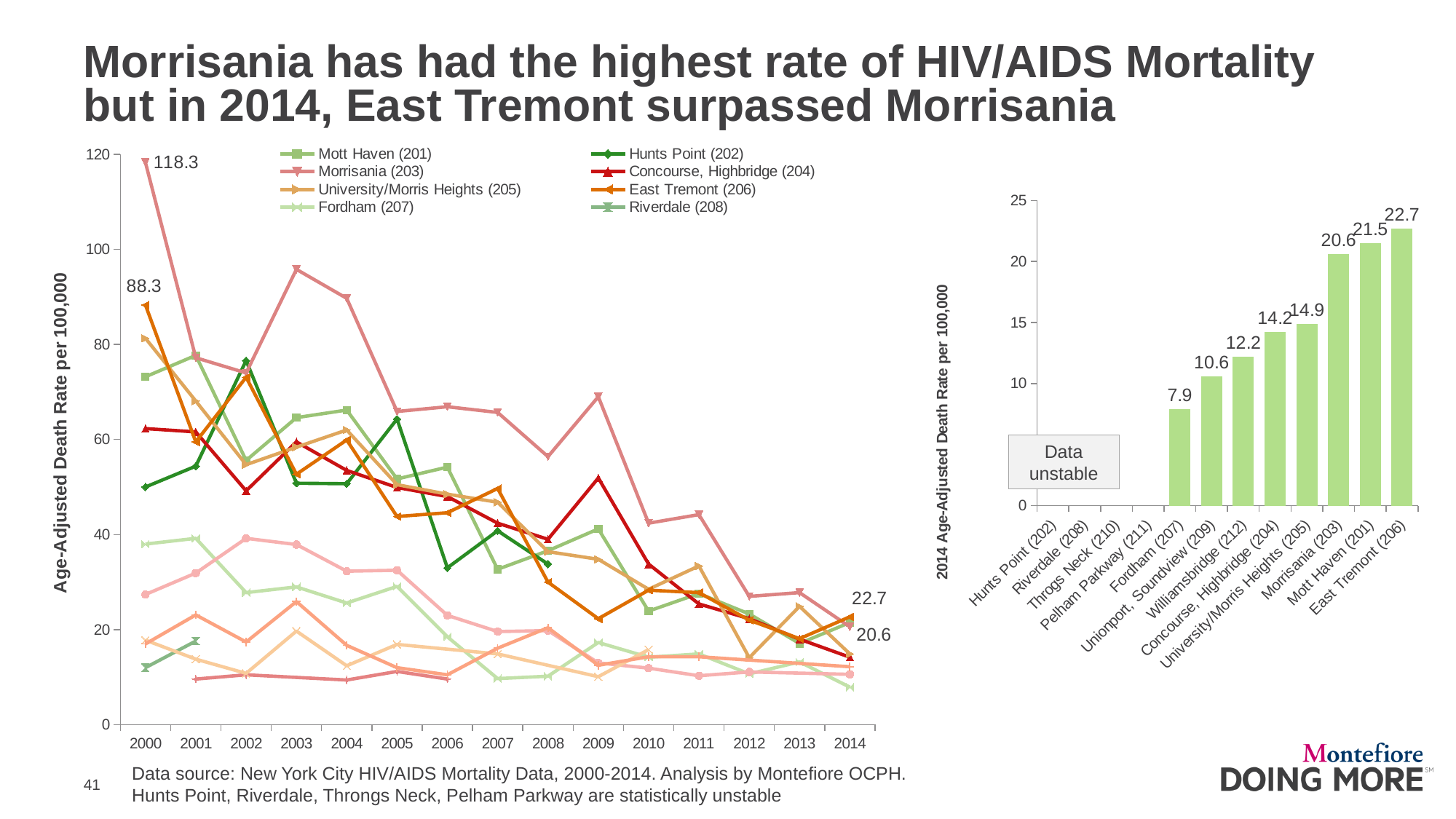
In the line chart on the left, is the value for Mott Haven (201) in 2000 greater or less than 60? greater In the bar chart on the right, which neighborhood with a plotted bar has the lowest 2014 age-adjusted death rate? Fordham (207) In the bar chart on the right, which has the higher 2014 rate: Williamsbridge (212) or Unionport, Soundview (209)? Williamsbridge (212) In the line chart on the left, what was the age-adjusted death rate for East Tremont (206) in 2000? 88.3 In the bar chart on the right, which neighborhood has the highest 2014 age-adjusted death rate? East Tremont (206) In the line chart on the left, what was the age-adjusted death rate for Morrisania (203) in 2000? 118.3 In the bar chart on the right, how many neighborhoods have a plotted bar with a value? 8 What kind of chart is the chart on the right side of the slide? Bar chart In the bar chart on the right, what is the 2014 age-adjusted death rate for East Tremont (206)? 22.7 In the line chart on the left, how many series does the legend list? 8 In the line chart on the left, does the Morrisania (203) rate generally rise or fall from 2000 to 2014? Fall In the bar chart on the right, what is the difference between the 2014 rates for East Tremont (206) and Morrisania (203)? 2.1